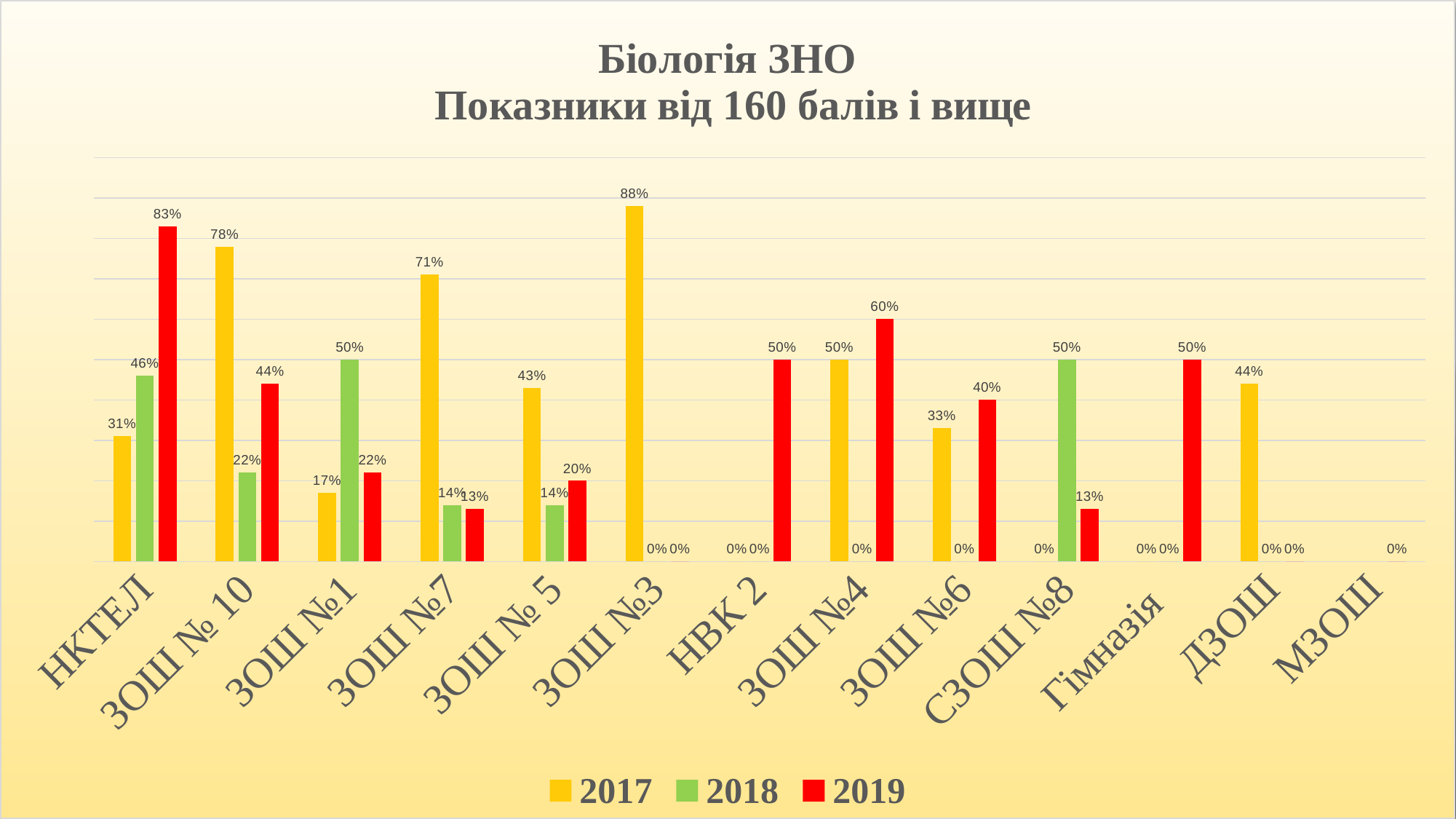
How many series does the legend list? 3 What is the 2018 value for СЗОШ №8? 50% Which colour represents the 2018 series in the legend? green What is the difference between the 2017 and 2019 values for ЗОШ № 10? 34% What is the 2017 value for ЗОШ №7? 71% What is the 2019 value for НКТЕЛ? 83% Which is larger for ЗОШ №4: the 2017 value or the 2019 value? 2019 Which school has the highest 2019 value? НКТЕЛ Which school has the highest 2017 value? ЗОШ №3 What is the difference between the 2018 and 2019 values for ЗОШ №1? 28% How many categories (schools) are shown on the x axis? 13 What type of chart is shown on the slide? bar chart